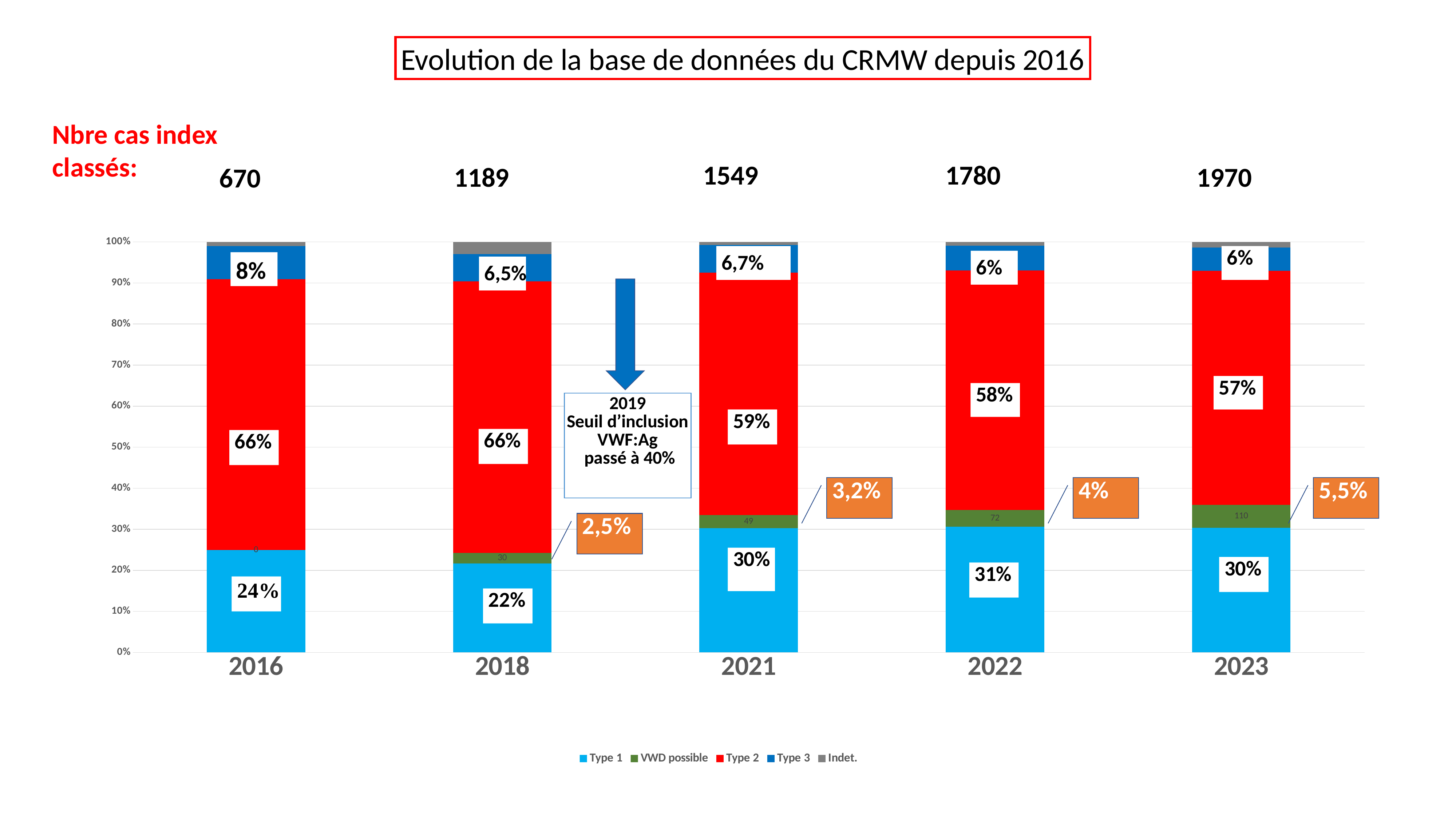
How many years are shown on the x axis? 5 What is the Type 1 share for 2022? 31% Does the Type 2 share rise or fall from 2018 to 2023? Fall What is the Type 3 share for 2018? 6,5% Which year has the lowest Type 1 share? 2018 What is the Type 2 share for 2021? 59% What is the VWD possible share for 2023? 5,5% What is the difference between the Type 2 share in 2016 and in 2023? 9 percentage points Which year has the highest Type 2 share? 2016 and 2018 (66%) Is the Type 3 share larger in 2016 or in 2022? 2016 How many series does the legend list? 5 What kind of chart is shown? Stacked bar chart